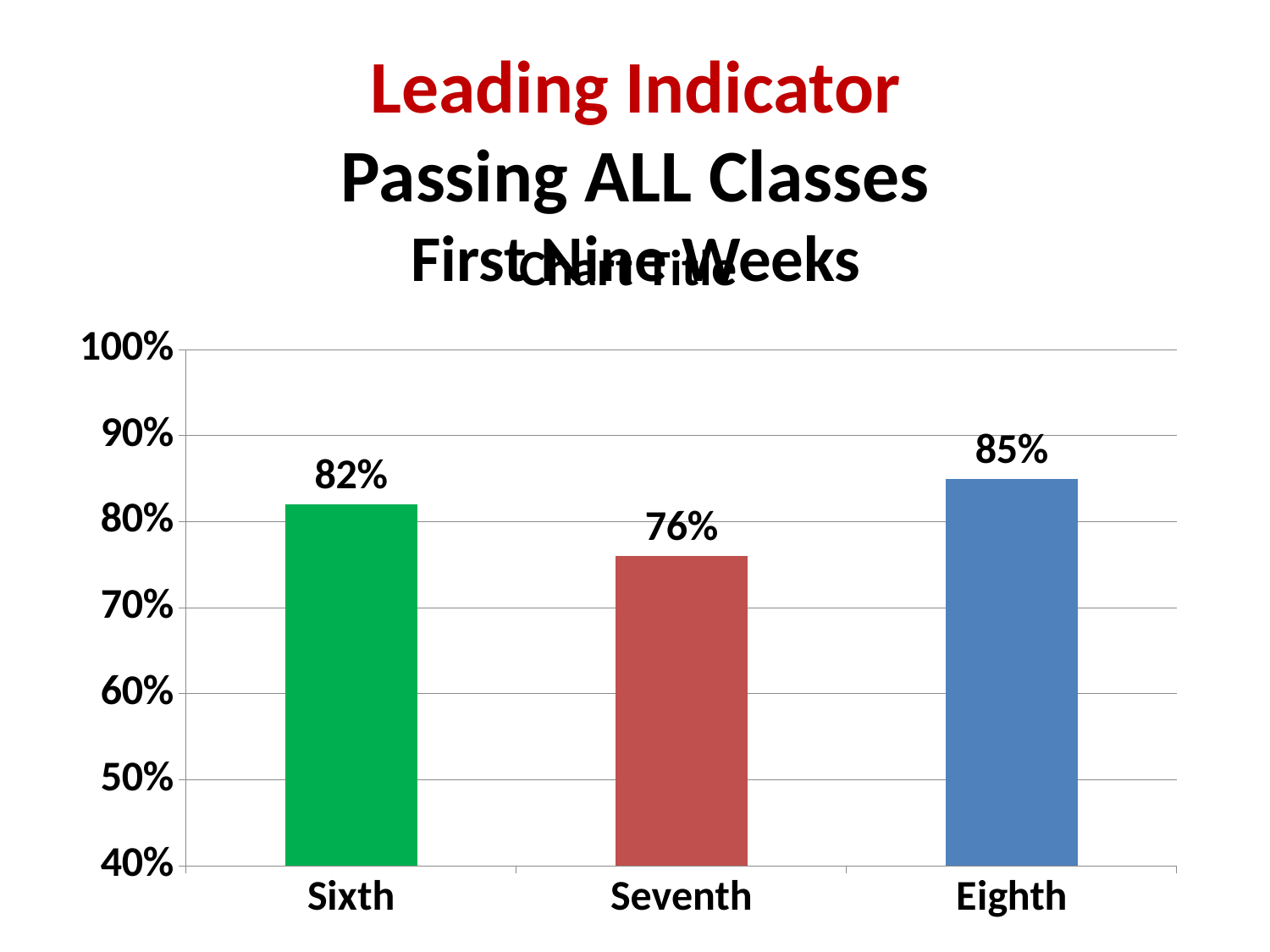
What is the value shown for Seventh? 76% What is the value shown for Eighth? 85% What kind of chart is shown on the slide? bar chart What is the difference between the Eighth and Seventh values? 9% Which grade has the highest percentage passing all classes? Eighth What colour is the bar for Seventh? red Which is larger, the value for Sixth or the value for Eighth? Eighth What percentage of Sixth graders are passing all classes? 82% What is the difference between the Sixth and Seventh values? 6% How many grade categories are shown on the chart? 3 Is the value for Seventh greater or less than 80%? less Which grade has the lowest percentage passing all classes? Seventh